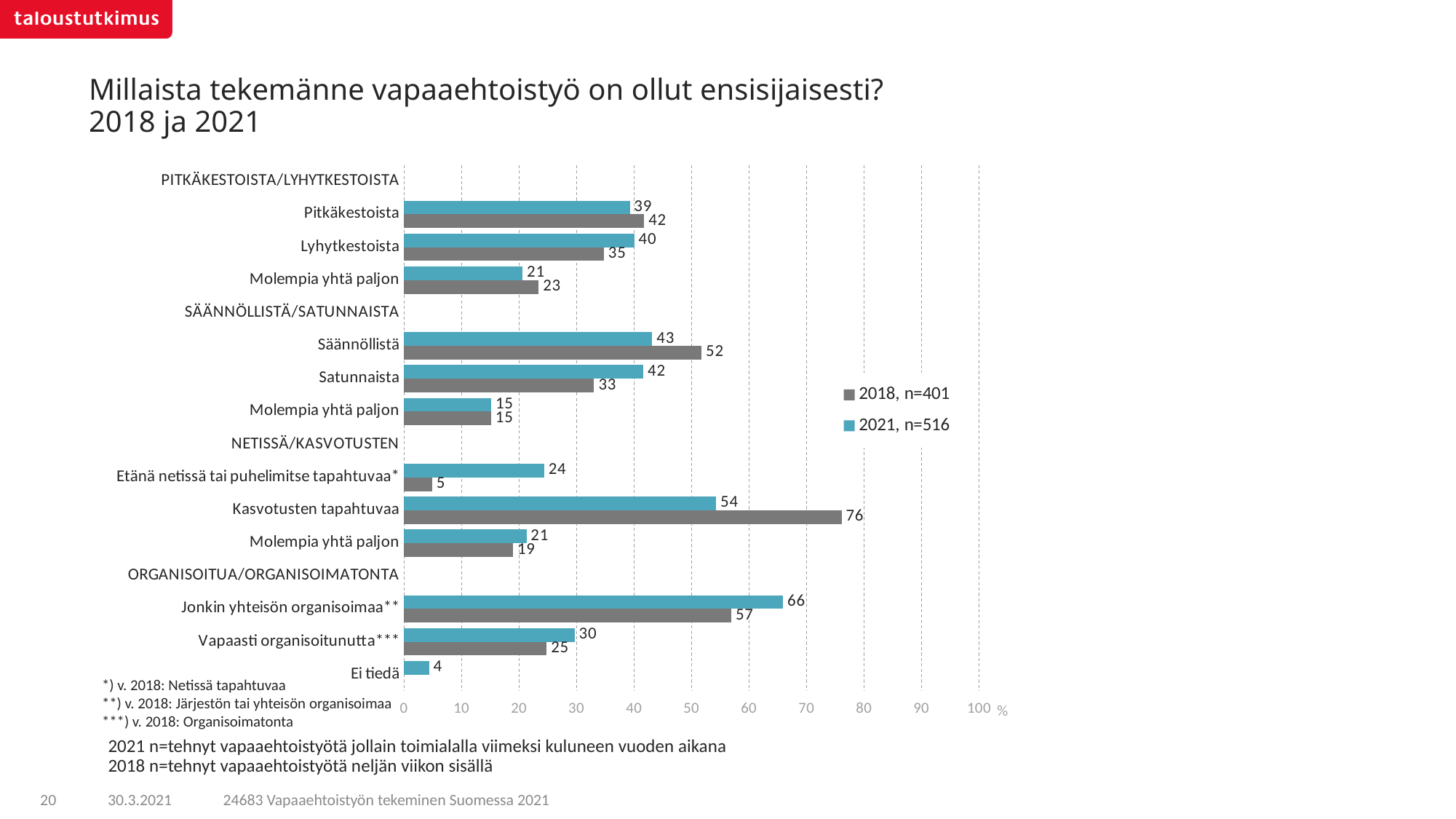
By how much does the 2018 value for Säännöllistä exceed the 2021 value? 9 For Lyhytkestoista, which year has the larger value, 2018 or 2021? 2021 How many series does the legend list? 2 Which category has the highest 2018 value? Kasvotusten tapahtuvaa What is the 2021 value for Jonkin yhteisön organisoimaa? 66 What is the 2018 value for Satunnaista? 33 What is the 2021 value for Ei tiedä? 4 What is the difference between the 2021 and 2018 values for Etänä netissä tai puhelimitse tapahtuvaa? 19 What is the 2018 value for Kasvotusten tapahtuvaa? 76 According to the legend, what is the sample size (n) for 2021? 516 Which category has the lowest 2018 value? Etänä netissä tai puhelimitse tapahtuvaa What kind of chart is shown on the slide? Bar chart